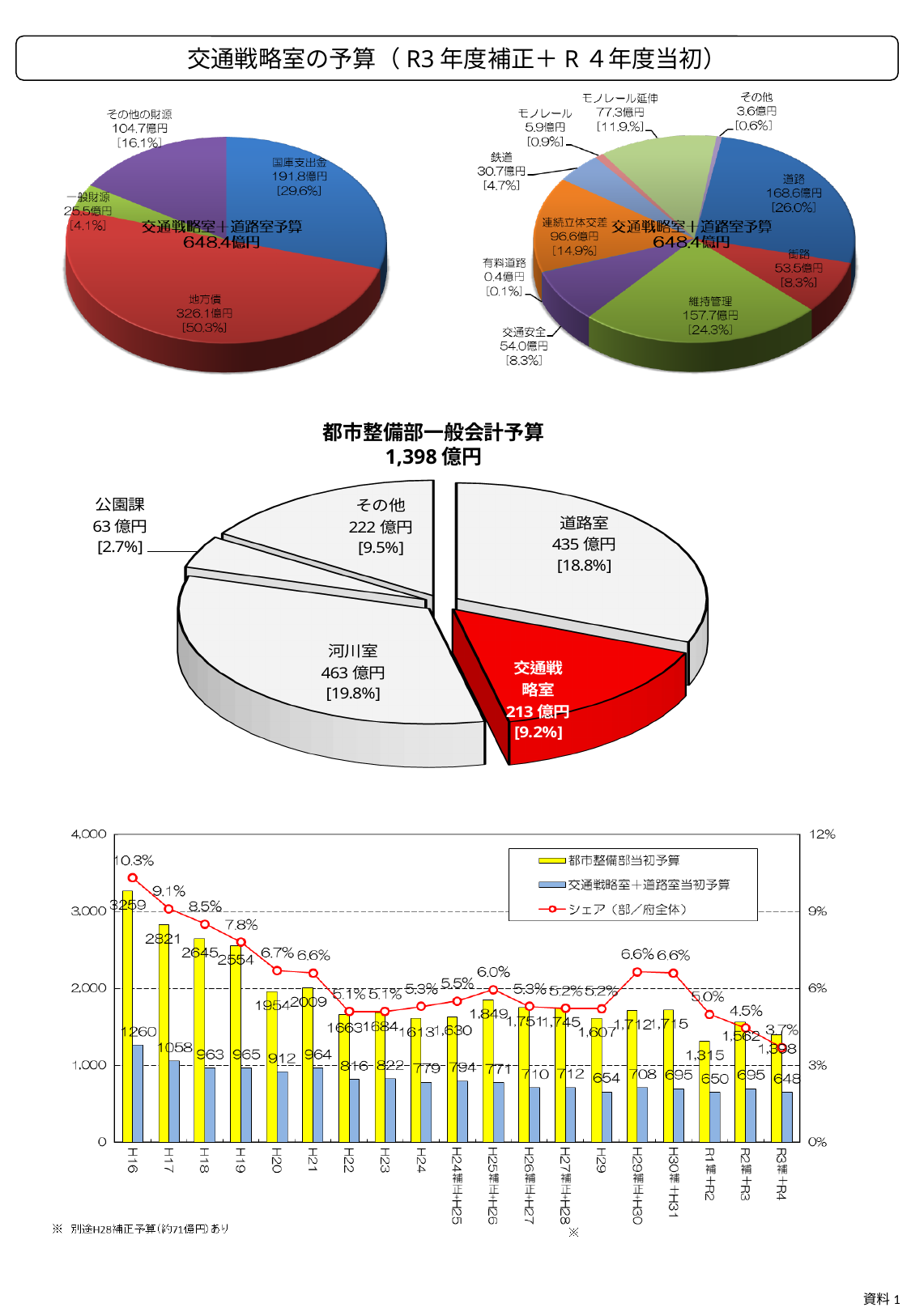
In the bottom chart, how many series does the legend list? 3 In the top-right pie chart (交通戦略室＋道路室予算 648.4億円), what is the value for 連続立体交差? 96.6億円 In the middle pie chart (都市整備部一般会計予算 1,398億円), what is the difference between 河川室 and 道路室? 28億円 In the middle pie chart (都市整備部一般会計予算 1,398億円), what is the value for 交通戦略室? 213億円 In the top-right pie chart (交通戦略室＋道路室予算 648.4億円), which category has the smallest value? 有料道路 In the bottom chart, is the value of 交通戦略室＋道路室当初予算 for H17 larger or smaller than for H18? larger In the bottom chart, what is the value of 都市整備部当初予算 for H16? 3259 In the top-left pie chart (交通戦略室＋道路室予算 648.4億円), what is the value for 地方債? 326.1億円 In the bottom chart, what is the シェア（部／府全体） value for R3補+R4? 3.7% In the middle pie chart (都市整備部一般会計予算 1,398億円), how many slices are there? 5 In the top-left pie chart (交通戦略室＋道路室予算 648.4億円), what share of the pie does 国庫支出金 represent? 29.6% In the top-right pie chart (交通戦略室＋道路室予算 648.4億円), which category has the largest value? 道路